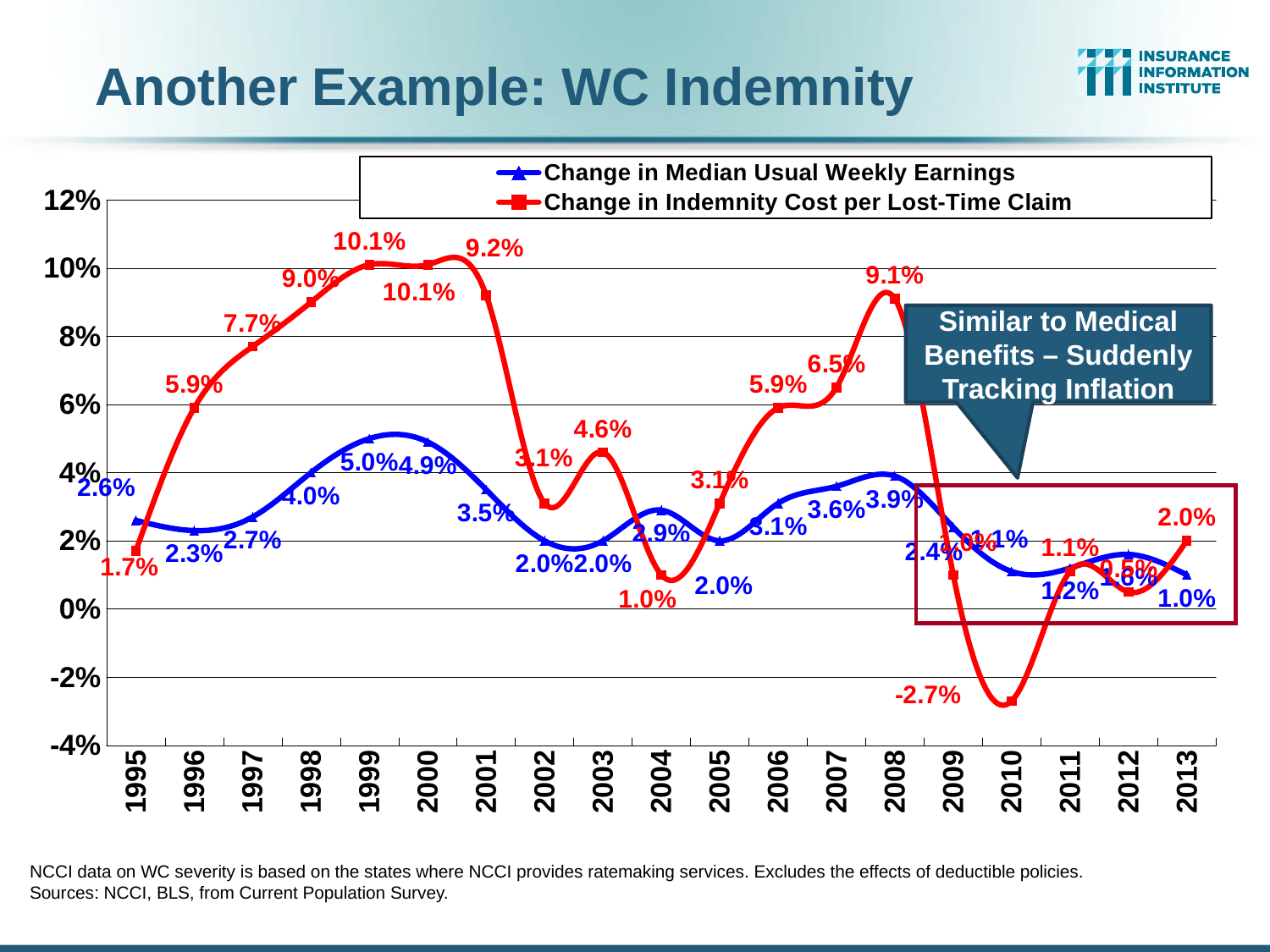
How many series does the legend list? 2 What is the Change in Indemnity Cost per Lost-Time Claim in 2008? 9.1% Does the Change in Indemnity Cost per Lost-Time Claim rise or fall from 1995 to 1999? rise What is the Change in Median Usual Weekly Earnings in 1999? 5.0% In which year is the Change in Indemnity Cost per Lost-Time Claim lowest? 2010 What kind of chart is shown on the slide? line chart What colour is the line for Change in Indemnity Cost per Lost-Time Claim? red How many years are plotted along the x axis? 19 In 2004, which series has the larger value: Change in Median Usual Weekly Earnings or Change in Indemnity Cost per Lost-Time Claim? Change in Median Usual Weekly Earnings What is the Change in Indemnity Cost per Lost-Time Claim in 1999? 10.1% In 2008, how much higher is the Change in Indemnity Cost per Lost-Time Claim than the Change in Median Usual Weekly Earnings? 5.2 percentage points What is the Change in Indemnity Cost per Lost-Time Claim in 2010? -2.7%